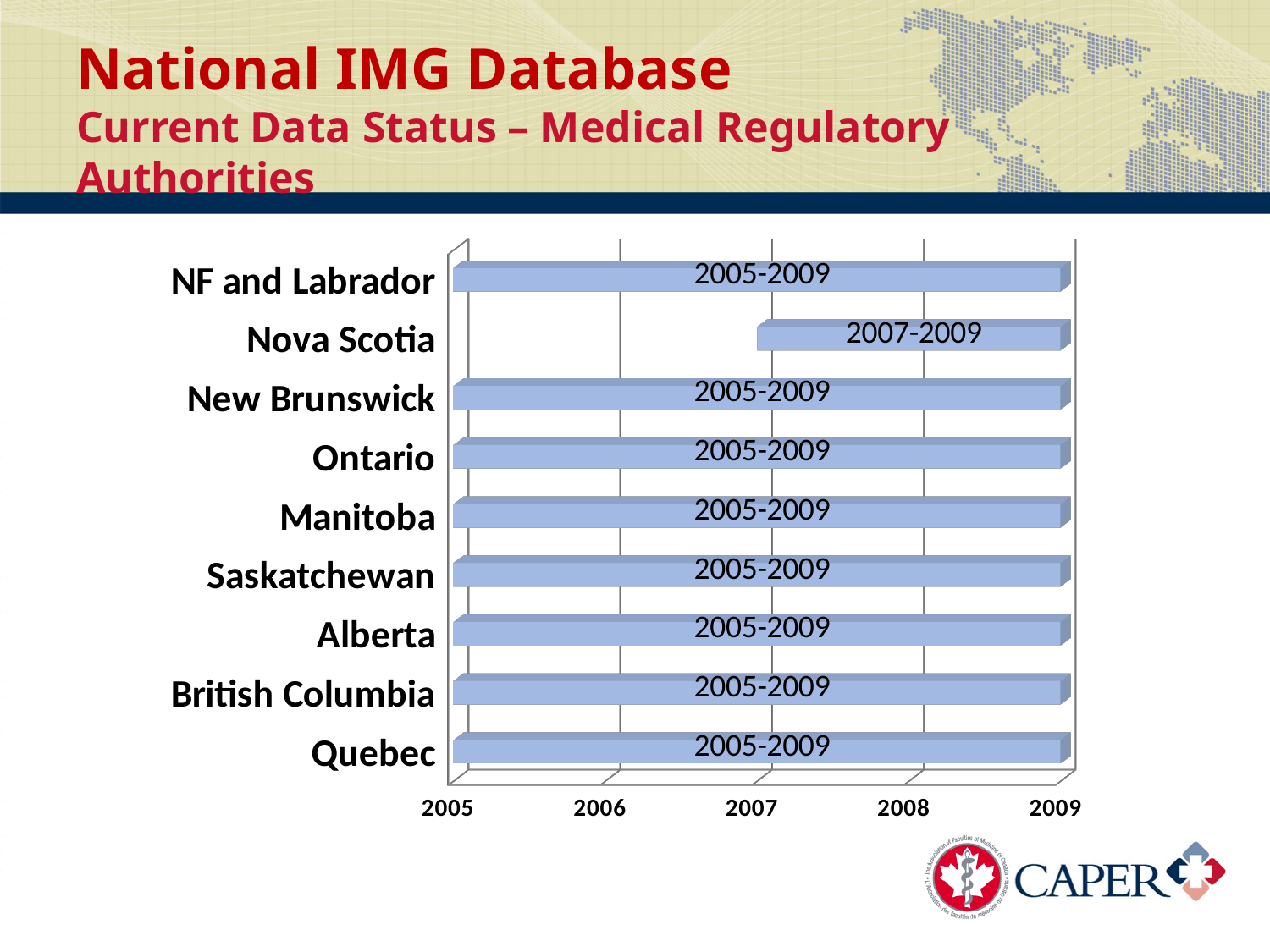
What data range is shown for Nova Scotia? 2007-2009 What data range is shown for Ontario? 2005-2009 Which bar is longer, Nova Scotia or Saskatchewan? Saskatchewan Which medical regulatory authority has the shortest bar (the fewest years of data)? Nova Scotia What data range is shown for Quebec? 2005-2009 What kind of chart is shown on the slide? Bar chart How many authorities have data for 2005-2009? 8 What is the last year shown on the horizontal axis? 2009 What is the first year shown on the horizontal axis? 2005 How many medical regulatory authorities are listed on the chart? 9 What data range is shown for NF and Labrador? 2005-2009 In which year does the Nova Scotia bar start? 2007